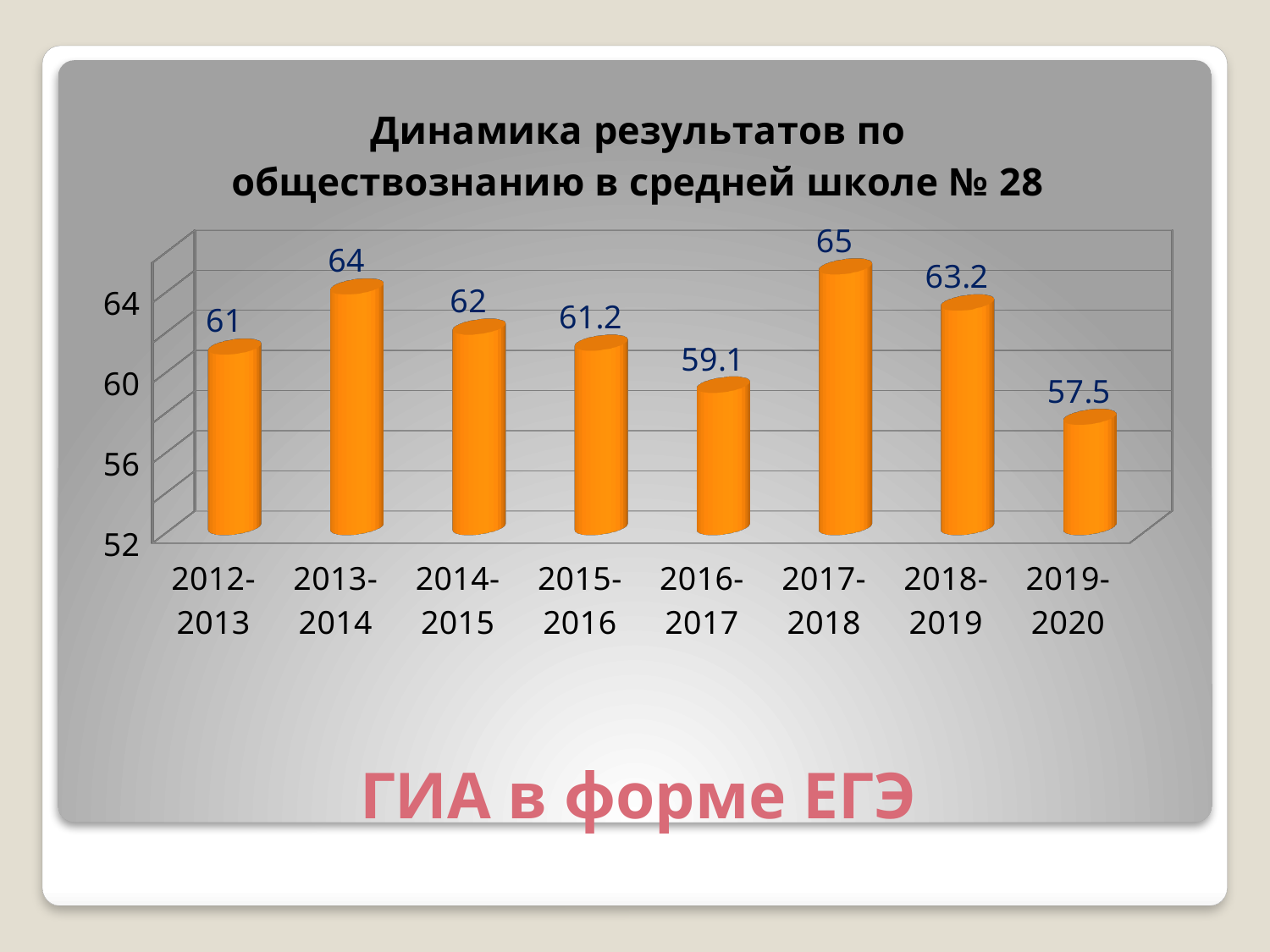
Which is larger, the value for 2014-2015 or the value for 2018-2019? 2018-2019 What is the difference between the values for 2013-2014 and 2012-2013? 3 Which year has the highest value? 2017-2018 What is the title of the chart? Динамика результатов по обществознанию в средней школе № 28 What kind of chart is shown on the slide? bar chart Is the value for 2016-2017 greater or less than 60? less What is the value for 2019-2020? 57.5 What is the value for 2017-2018? 65 What is the difference between the values for 2017-2018 and 2019-2020? 7.5 What is the value for 2016-2017? 59.1 How many years are shown on the chart? 8 Which year has the lowest value? 2019-2020